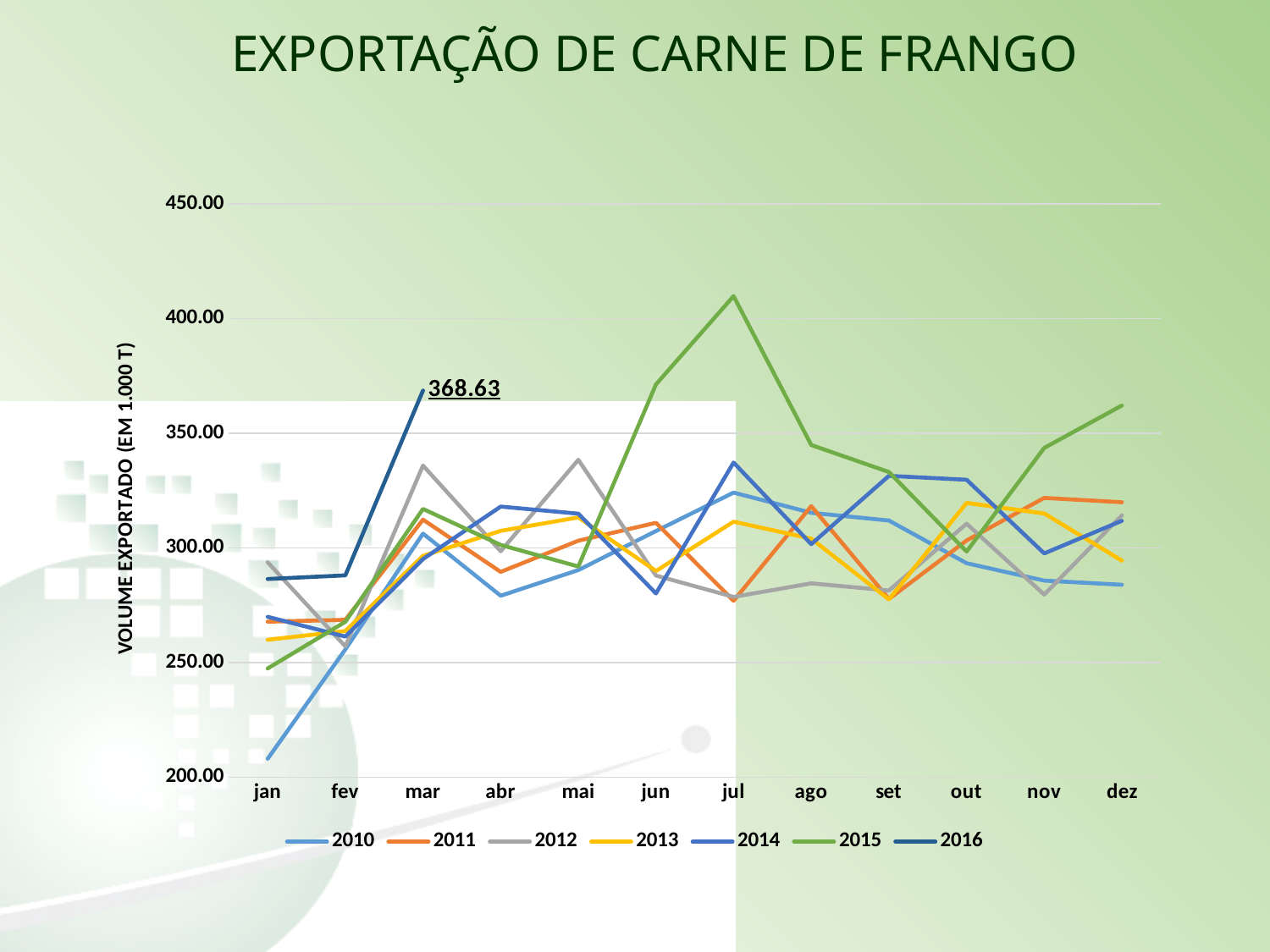
For how many months does the 2016 series have data points? 3 What kind of chart is shown on the slide? line chart Is the value for 2015 in jul greater or less than 400.00? greater Which year has the lowest value in jan? 2010 How many months are shown along the x axis? 12 How many series does the legend list? 7 Does the 2016 line rise or fall from jan to mar? rise What is the labelled value for the 2016 series in mar? 368.63 What is the title of the vertical axis? VOLUME EXPORTADO (EM 1.000 T) In jun, which is larger: the value for 2015 or the value for 2010? 2015 Is the value for 2010 in jan greater or less than 250.00? less Which year has the highest value in jul? 2015